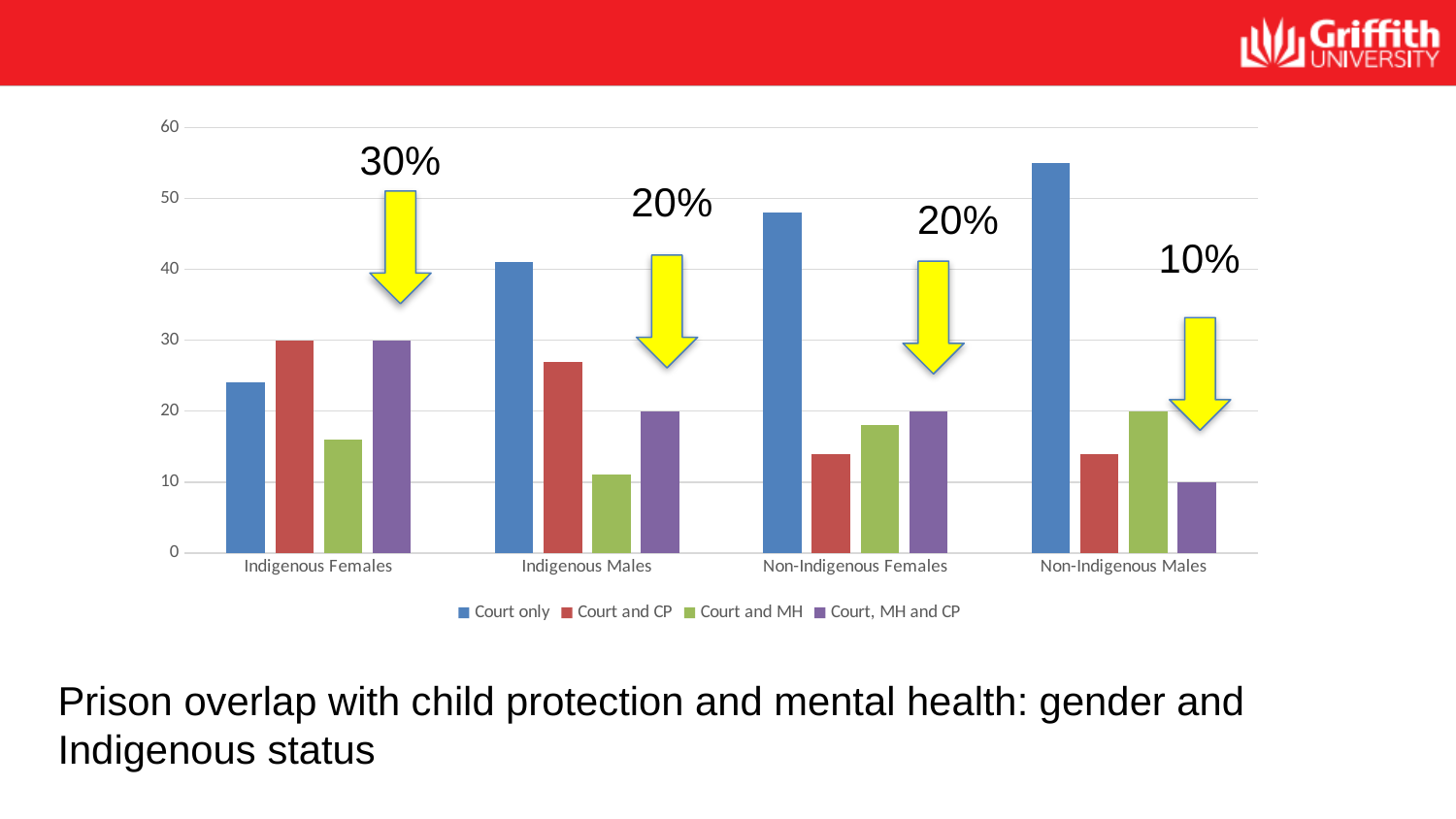
Which category has the lowest Court only value? Indigenous Females What percentage is annotated above the Court, MH and CP bar for Indigenous Females? 30% Which is larger for Indigenous Females: the Court only value or the Court and CP value? Court and CP Is the Court only value for Non-Indigenous Females greater or less than 40? greater How many categories are shown on the x axis? 4 Which series is shown in purple in the legend? Court, MH and CP What percentage is annotated above the Court, MH and CP bar for Indigenous Males? 20% What percentage is annotated above the Court, MH and CP bar for Non-Indigenous Males? 10% How many series does the legend list? 4 Which category has the highest Court only value? Non-Indigenous Males What kind of chart is shown on the slide? bar chart Is the Court and MH value for Indigenous Males greater or less than 20? less